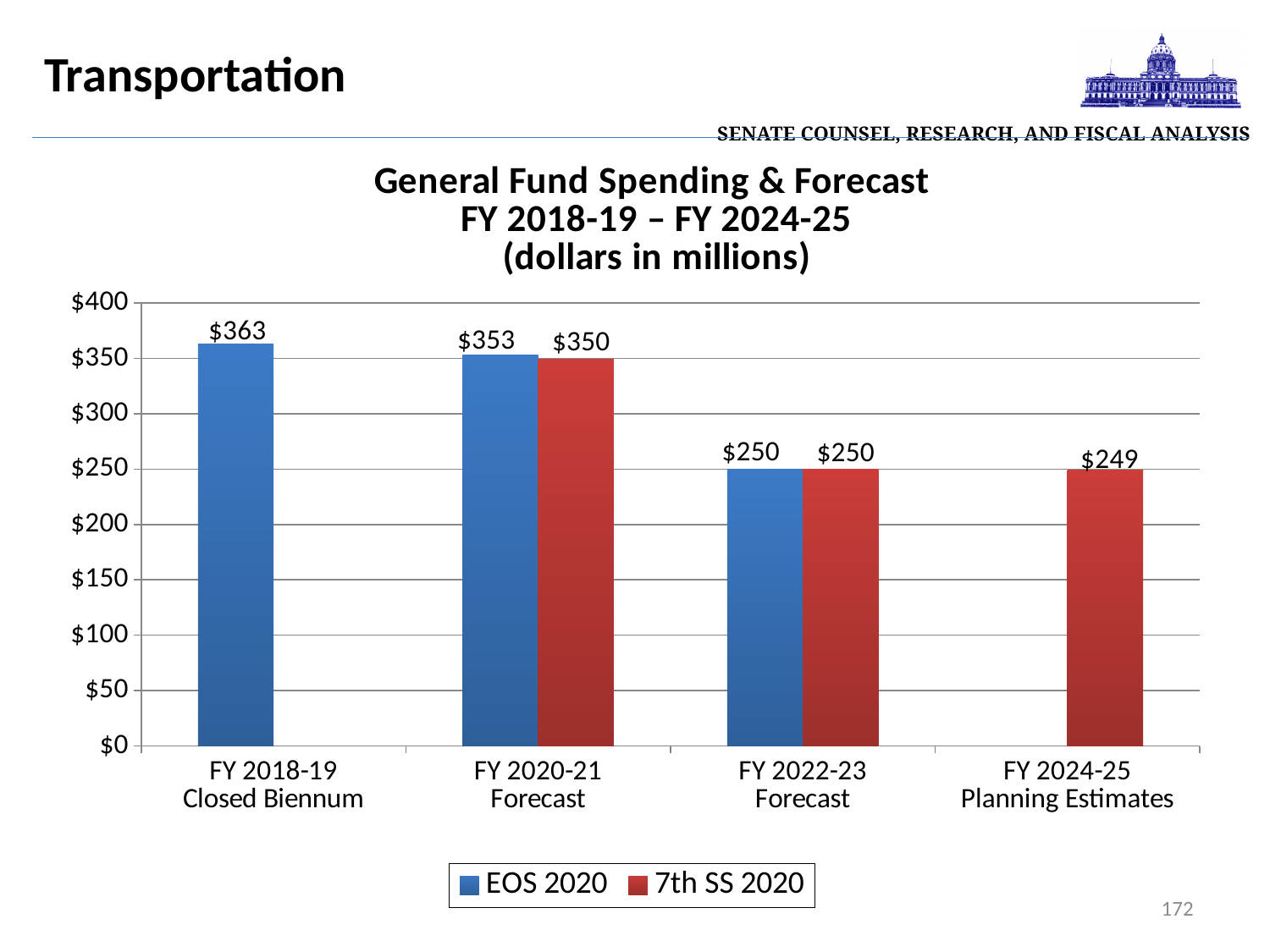
What is the 7th SS 2020 value for FY 2020-21 Forecast? $350 Which category has the highest EOS 2020 value? FY 2018-19 Closed Biennum What is the EOS 2020 value for FY 2022-23 Forecast? $250 Which category has the lowest 7th SS 2020 value? FY 2024-25 Planning Estimates What is the EOS 2020 value for FY 2018-19 Closed Biennum? $363 What kind of chart is shown on the slide? Bar chart What is the difference between the EOS 2020 and 7th SS 2020 values for FY 2020-21 Forecast? $3 Do the EOS 2020 values rise or fall from FY 2018-19 to FY 2022-23? Fall What is the 7th SS 2020 value for FY 2024-25 Planning Estimates? $249 Which is larger: the EOS 2020 value for FY 2018-19 Closed Biennum or the EOS 2020 value for FY 2022-23 Forecast? FY 2018-19 Closed Biennum How many series does the legend list? 2 What is the difference between the EOS 2020 values for FY 2018-19 Closed Biennum and FY 2020-21 Forecast? $10